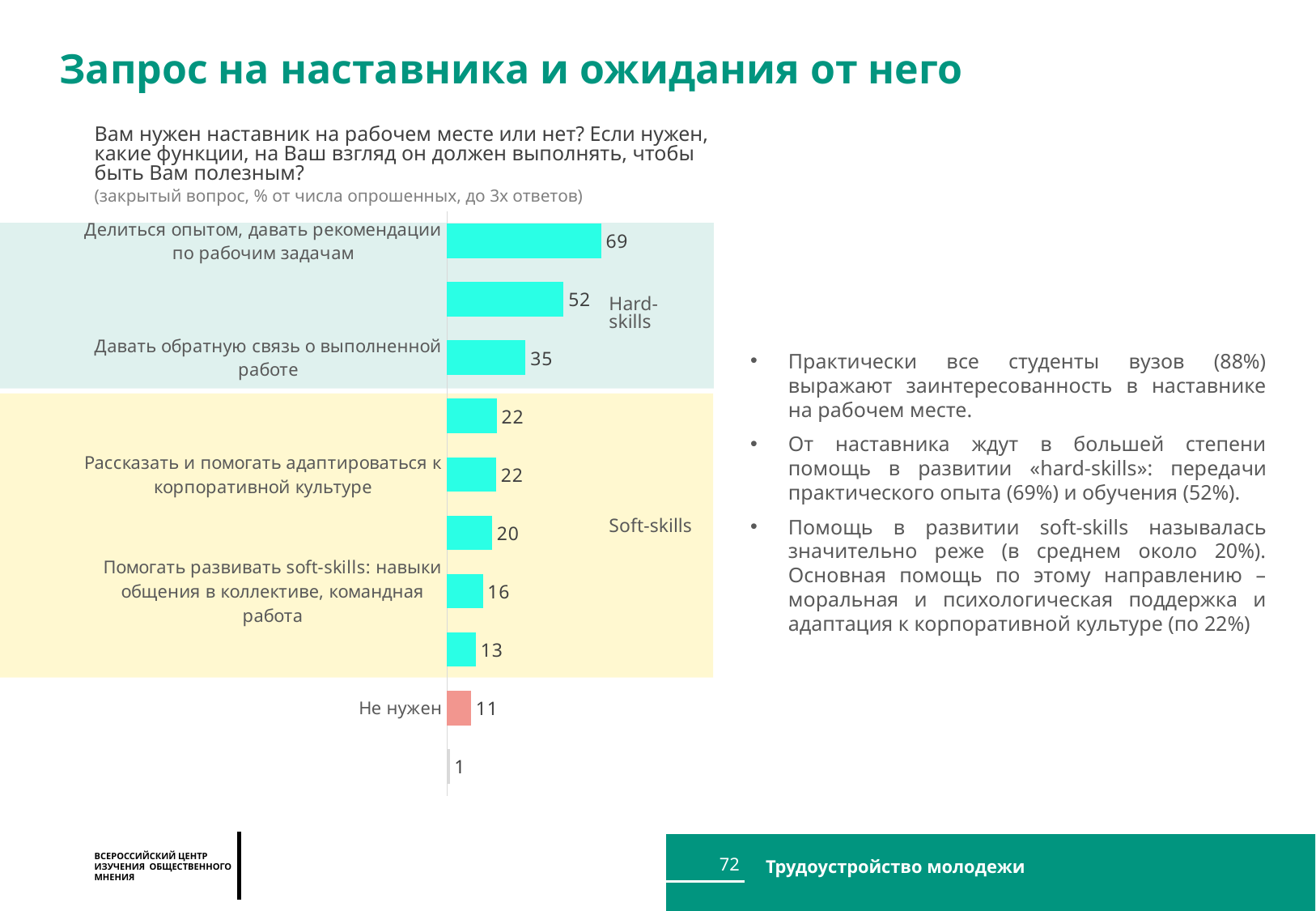
Which category has the highest value in the chart? Делиться опытом, давать рекомендации по рабочим задачам Which is larger: the value for "Давать обратную связь о выполненной работе" or the value for "Не нужен"? Давать обратную связь о выполненной работе What colour is the bar for "Не нужен"? Red (pink) What is the value of the shortest bar in the chart? 1 What is the difference between the values for "Делиться опытом, давать рекомендации по рабочим задачам" and "Давать обратную связь о выполненной работе"? 34 What is the value for "Давать обратную связь о выполненной работе"? 35 What is the value for "Не нужен"? 11 What is the value for "Рассказать и помогать адаптироваться к корпоративной культуре"? 22 What is the value for "Делиться опытом, давать рекомендации по рабочим задачам"? 69 What type of chart is shown on the slide? Bar chart How many bars are plotted in the chart? 10 What is the value for "Помогать развивать soft-skills: навыки общения в коллективе, командная работа"? 16